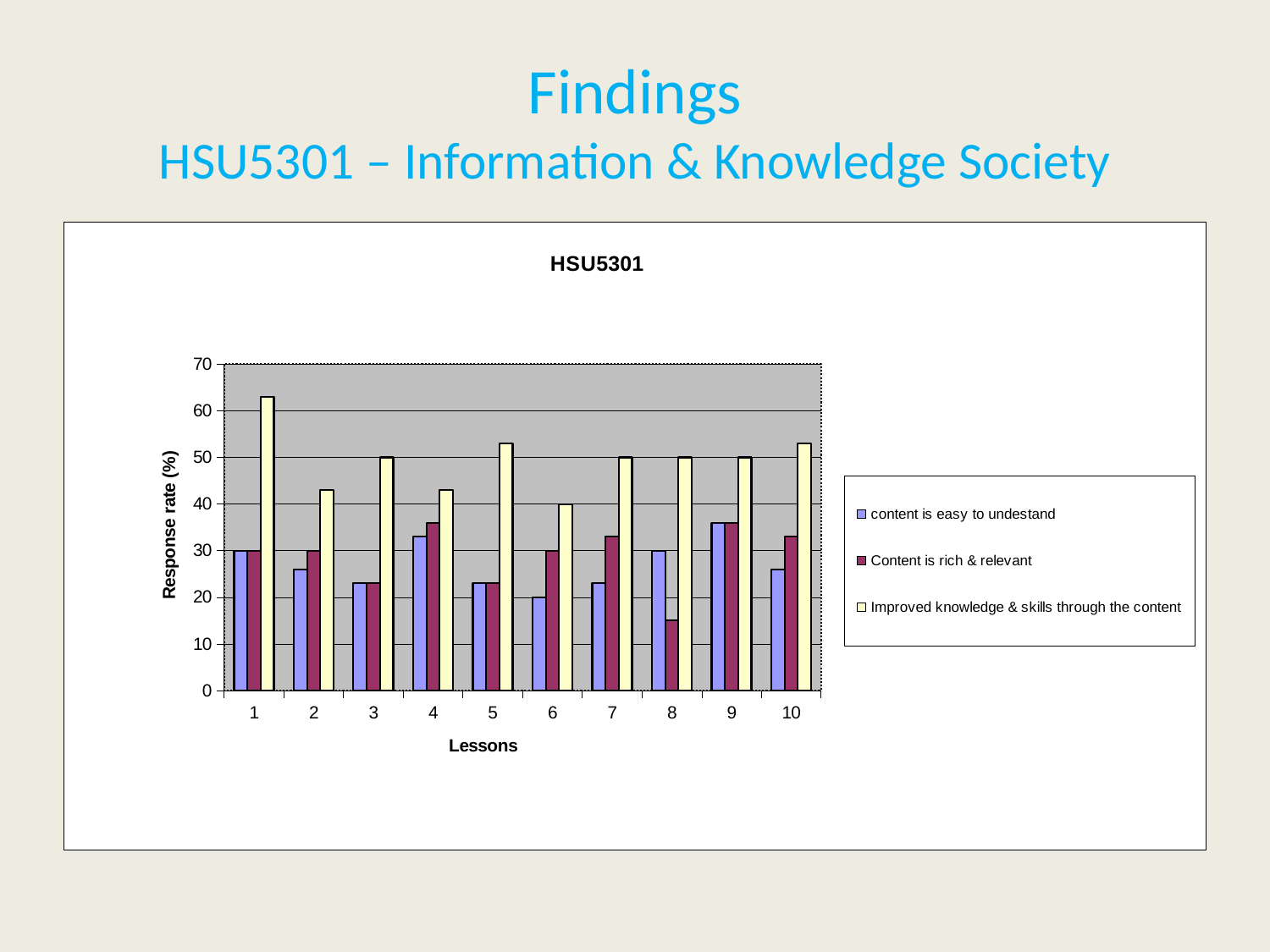
For which lesson is the 'Improved knowledge & skills through the content' value highest? 1 Is the 'Improved knowledge & skills through the content' value for lesson 1 greater or less than 60? greater What is the title of the chart? HSU5301 For which lesson is the 'Content is rich & relevant' value lowest? 8 What is the 'content is easy to undestand' value for lesson 1? 30 Is the 'Content is rich & relevant' value for lesson 8 greater or less than 20? less What type of chart is shown on the slide? bar chart Which lesson has the larger 'Improved knowledge & skills through the content' value, lesson 2 or lesson 3? 3 What is the 'Improved knowledge & skills through the content' value for lesson 6? 40 How many lessons are shown on the x axis of the chart? 10 What is the label on the vertical axis of the chart? Response rate (%) How many series does the chart's legend list? 3